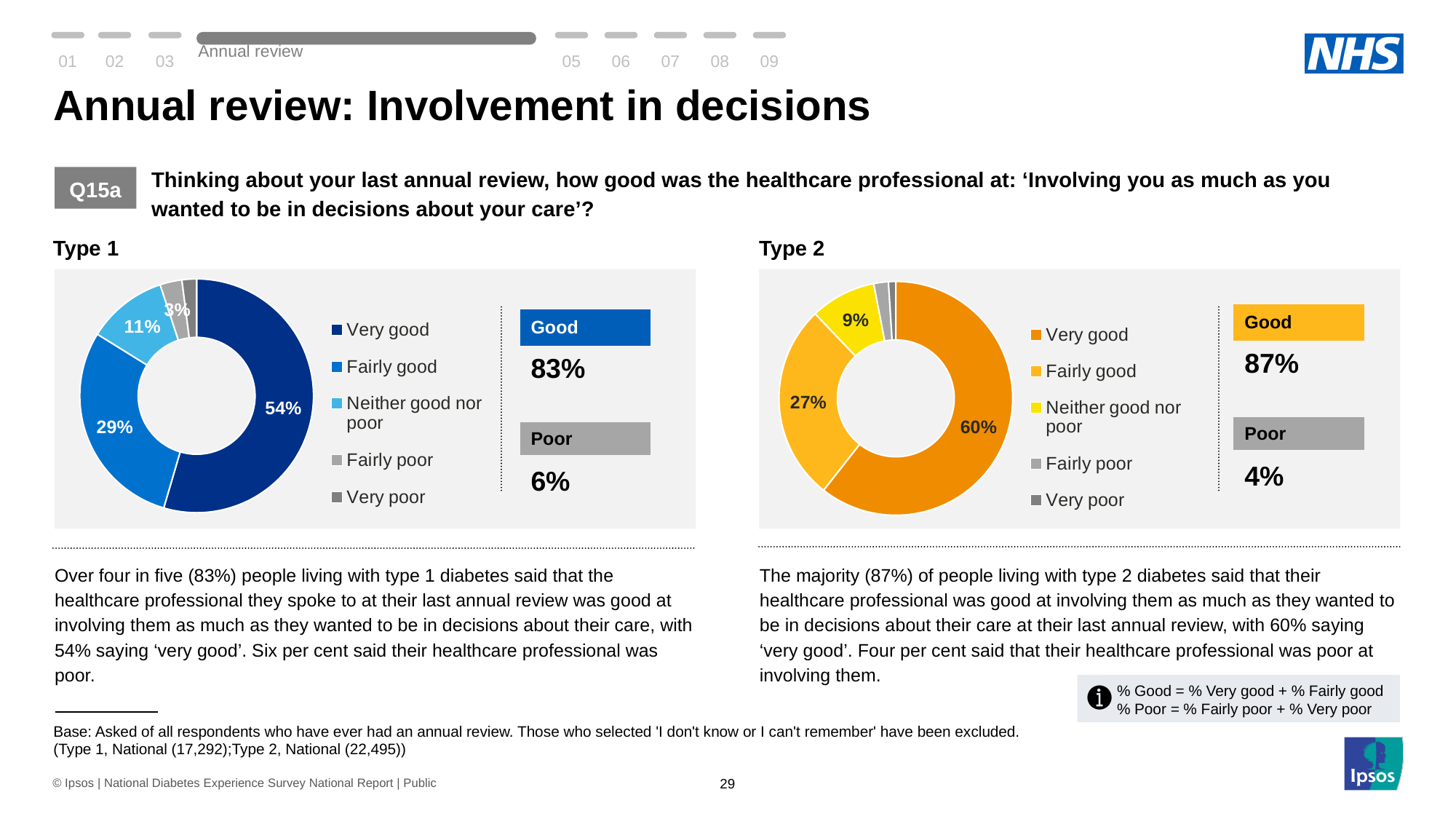
In the Type 1 chart, which response category has the largest share? Very good In the Type 2 chart, which response category has the largest share? Very good What is the combined 'Good' percentage shown next to the Type 1 chart? 83% Which chart shows a larger 'Very good' share, Type 1 or Type 2? Type 2 In the Type 2 chart, what percentage of respondents said 'Neither good nor poor'? 9% In the Type 1 chart, what is the difference between the 'Very good' and 'Fairly good' percentages? 25 percentage points In the Type 1 chart, what percentage of respondents said 'Very good'? 54% What kind of chart is used to show the Type 2 results? Pie (donut) chart How many response categories does the legend of the Type 1 chart list? 5 In the Type 2 chart, what percentage of respondents said 'Very good'? 60% In the Type 2 chart, what is the difference between the 'Very good' and 'Fairly good' percentages? 33 percentage points In the Type 1 chart, what percentage of respondents said 'Fairly good'? 29%